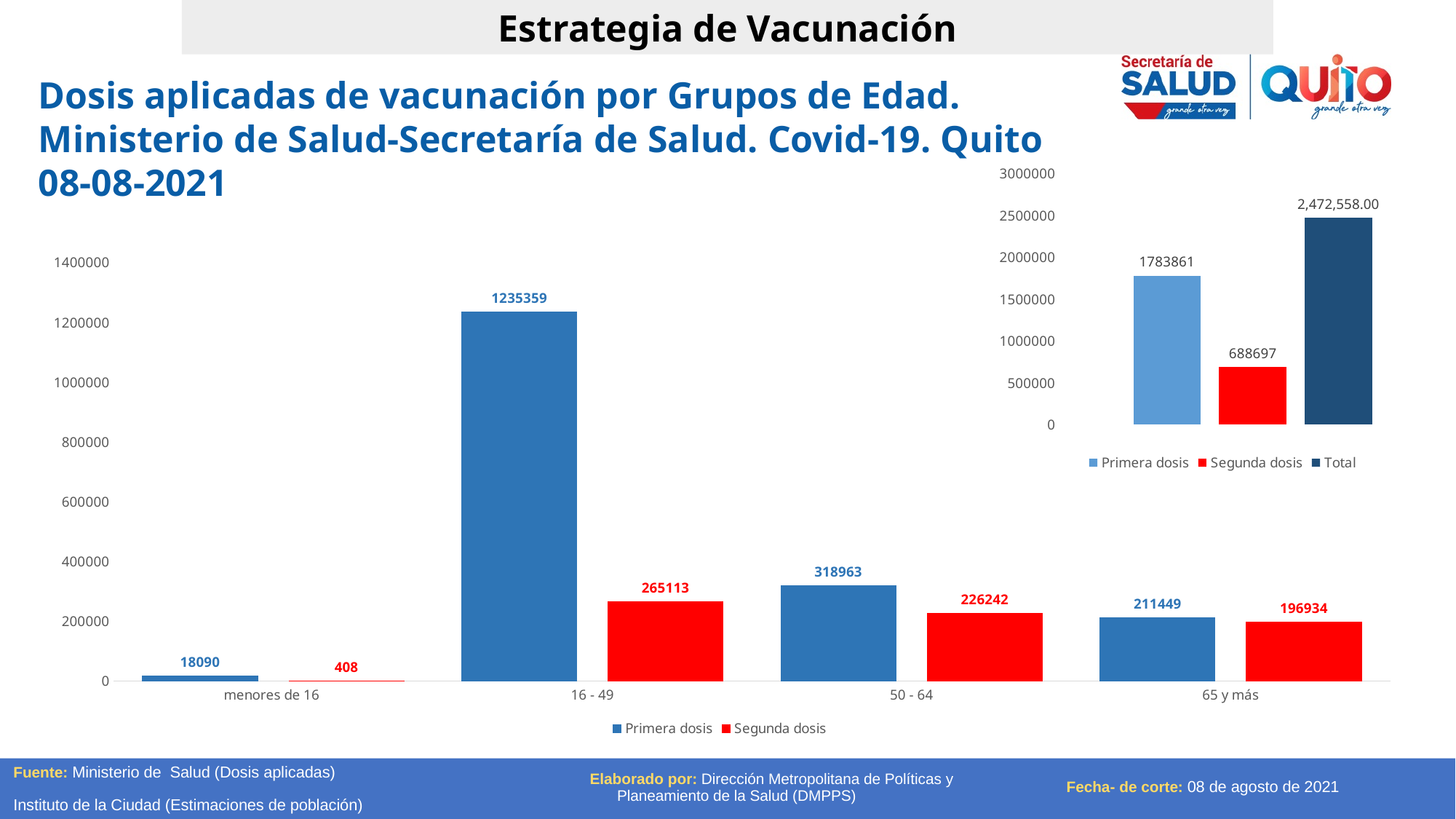
In the large chart on the left, which age group has the highest Primera dosis value? 16 - 49 In the large chart on the left, what is the difference between Primera dosis and Segunda dosis for the 50 - 64 group? 92721 In the large chart on the left, which is larger for the 65 y más group: Primera dosis or Segunda dosis? Primera dosis In the small chart in the top right, what is the difference between Primera dosis and Segunda dosis? 1095164 In the large chart on the left, what is the value of Segunda dosis for the menores de 16 group? 408 In the small chart in the top right, what is the value of Total? 2,472,558.00 In the large chart on the left, what is the value of Primera dosis for the 16 - 49 age group? 1235359 In the large chart on the left, how many age groups are shown on the x axis? 4 In the large chart on the left, how many series does the legend list? 2 In the large chart on the left, which age group has the lowest Segunda dosis value? menores de 16 What kind of chart is the small chart in the top right of the slide? bar chart In the small chart in the top right, what colour is the Segunda dosis bar? red